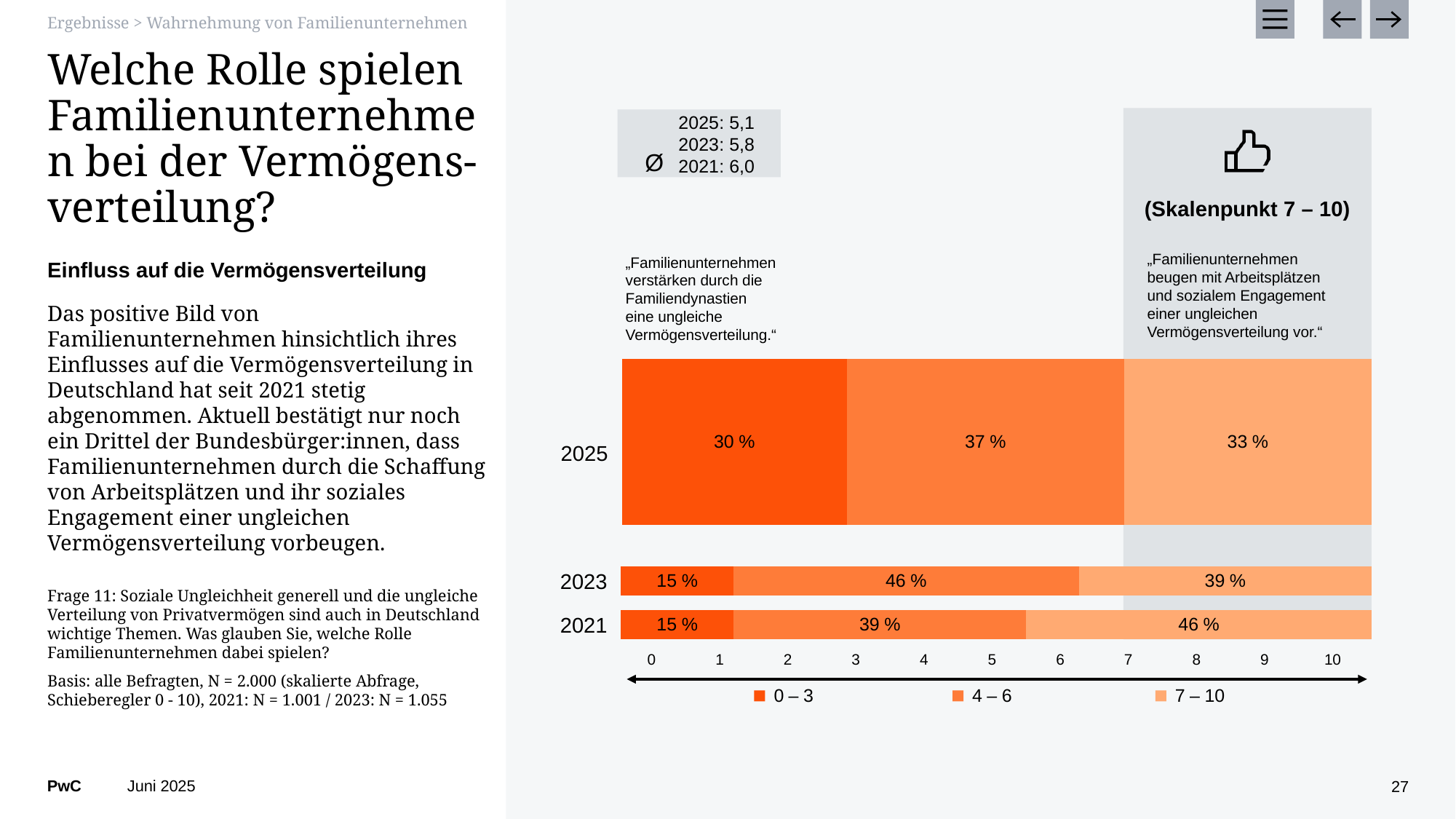
What percentage of respondents in 2021 chose scale points 7 – 10? 46 % Is the 4 – 6 share larger in 2023 or in 2021? 2023 By how many percentage points did the 7 – 10 share fall from 2021 to 2025? 13 percentage points How many categories does the legend list? 3 What kind of chart is shown on the slide? stacked bar chart How many years (bars) are shown in the chart? 3 What percentage of respondents in 2025 chose scale points 0 – 3? 30 % What percentage of respondents in 2023 chose scale points 4 – 6? 46 % Which year has the highest share of respondents in the 0 – 3 category? 2025 What is the average (Ø) value shown for 2025? 5,1 What percentage of respondents in 2025 chose scale points 7 – 10? 33 % Which year has the lowest share of respondents in the 7 – 10 category? 2025